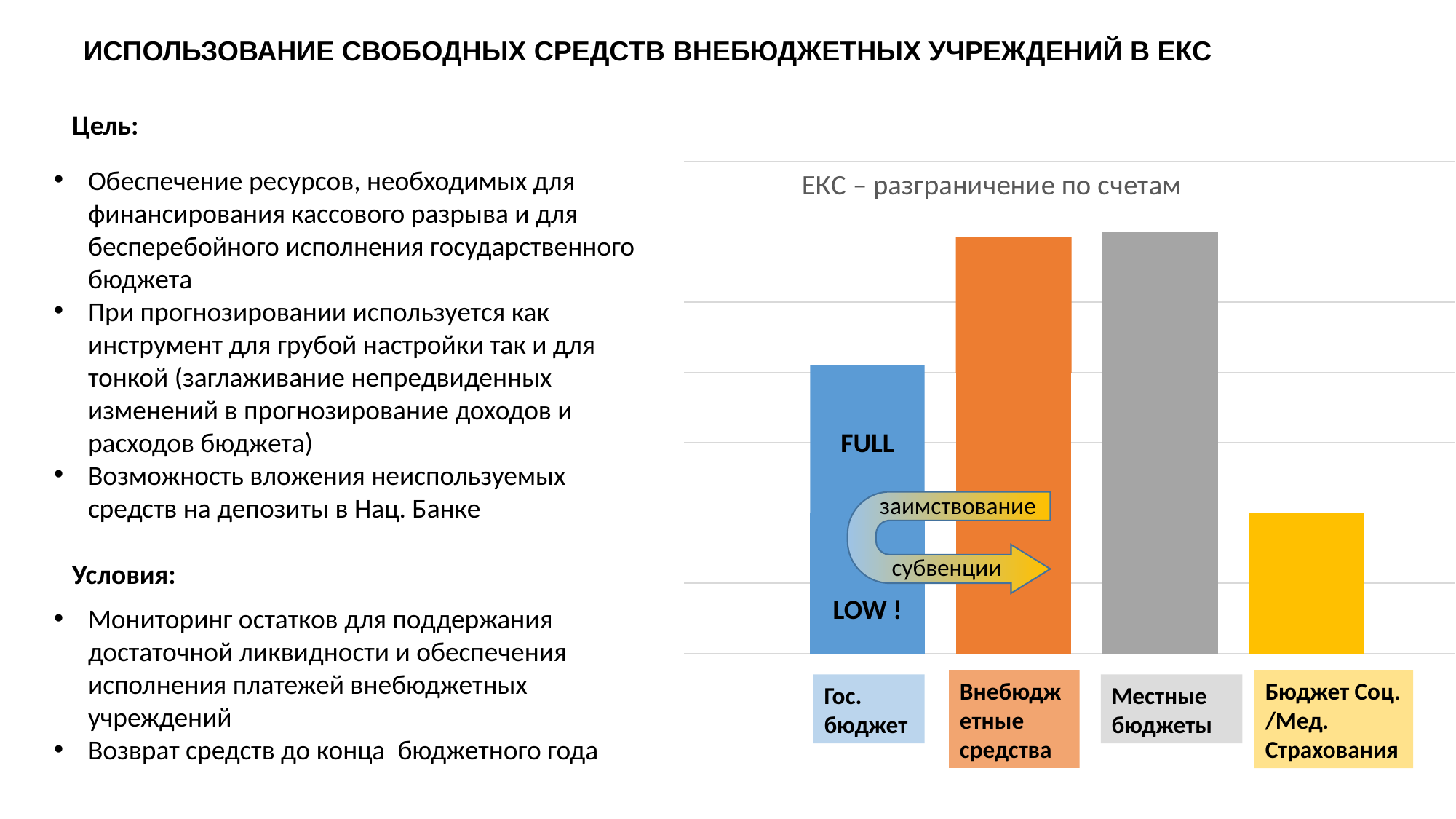
What is the title of the chart? ЕКС – разграничение по счетам What kind of chart is shown on the slide? bar chart Which bar is shorter: Гос. бюджет or Местные бюджеты? Гос. бюджет Which bar is taller: Гос. бюджет or Бюджет Соц./Мед. Страхования? Гос. бюджет Which bar is taller: Внебюджетные средства or Гос. бюджет? Внебюджетные средства Which category has the lowest bar in the chart? Бюджет Соц./Мед. Страхования How many categories (bars) does the chart show? 4 What colour is the bar for Гос. бюджет? blue